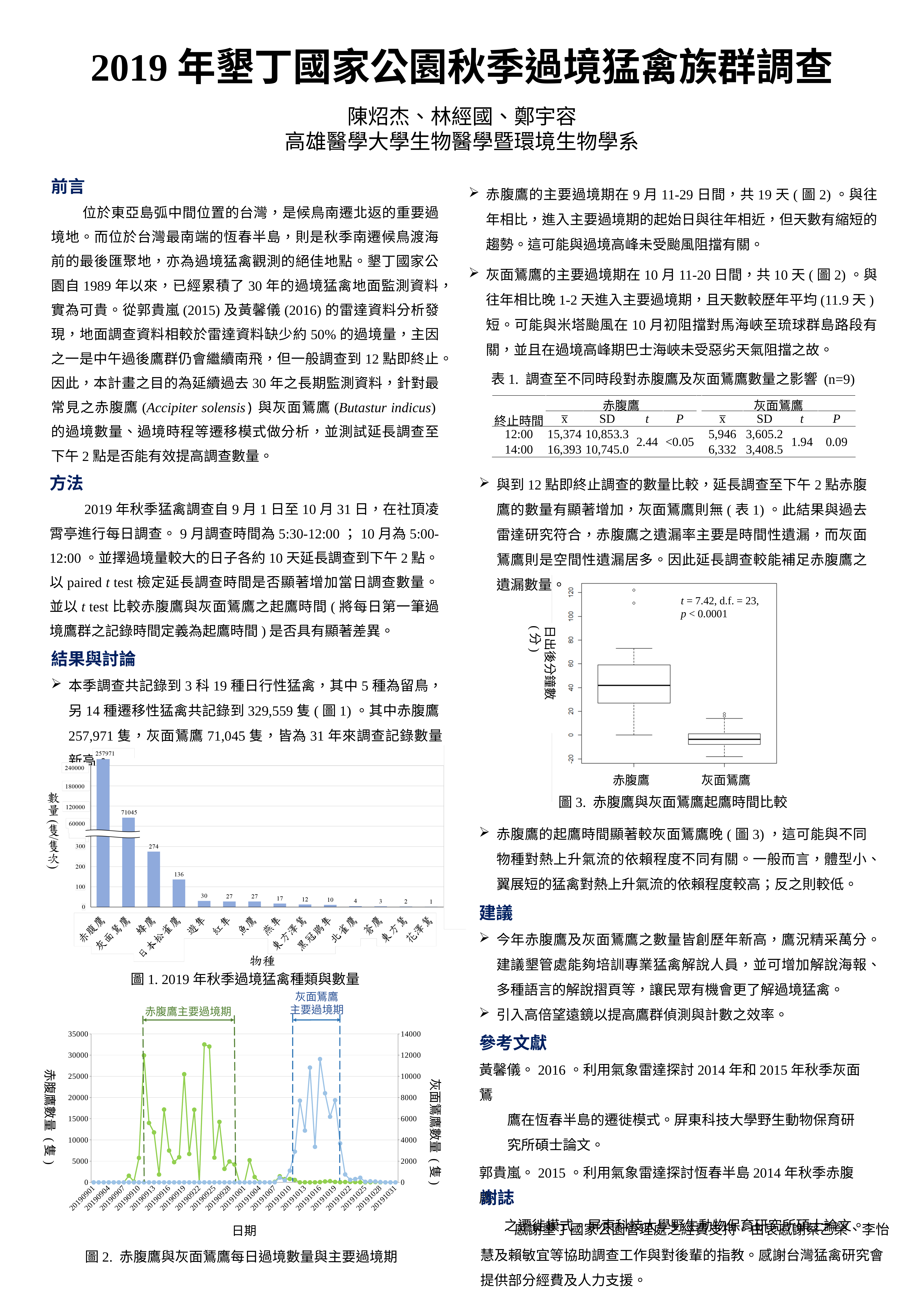
In Figure 1 (圖 1), which is larger, the value for 遊隼 or the value for 燕隼? 遊隼 In Figure 2 (圖 2), is the highest daily value for 赤腹鷹 greater or less than 30000? greater In Figure 2 (圖 2), how many series are plotted? 2 In Figure 1 (圖 1), what is the value for 灰面鵟鷹? 71045 In Figure 1 (圖 1), what is the value for 日本松雀鷹? 136 In Figure 1 (圖 1), what is the value for 赤腹鷹? 257971 In Figure 1 (圖 1), which species has the lowest count? 花澤鵟 What kind of chart is Figure 1 (圖 1)? bar chart In Figure 1 (圖 1), what is the difference between the values for 蜂鷹 and 日本松雀鷹? 138 In Figure 3 (圖 3), which species has the higher median 日出後分鐘數? 赤腹鷹 In Figure 1 (圖 1), how many species categories are shown on the x axis? 14 In Figure 1 (圖 1), which species has the highest count? 赤腹鷹